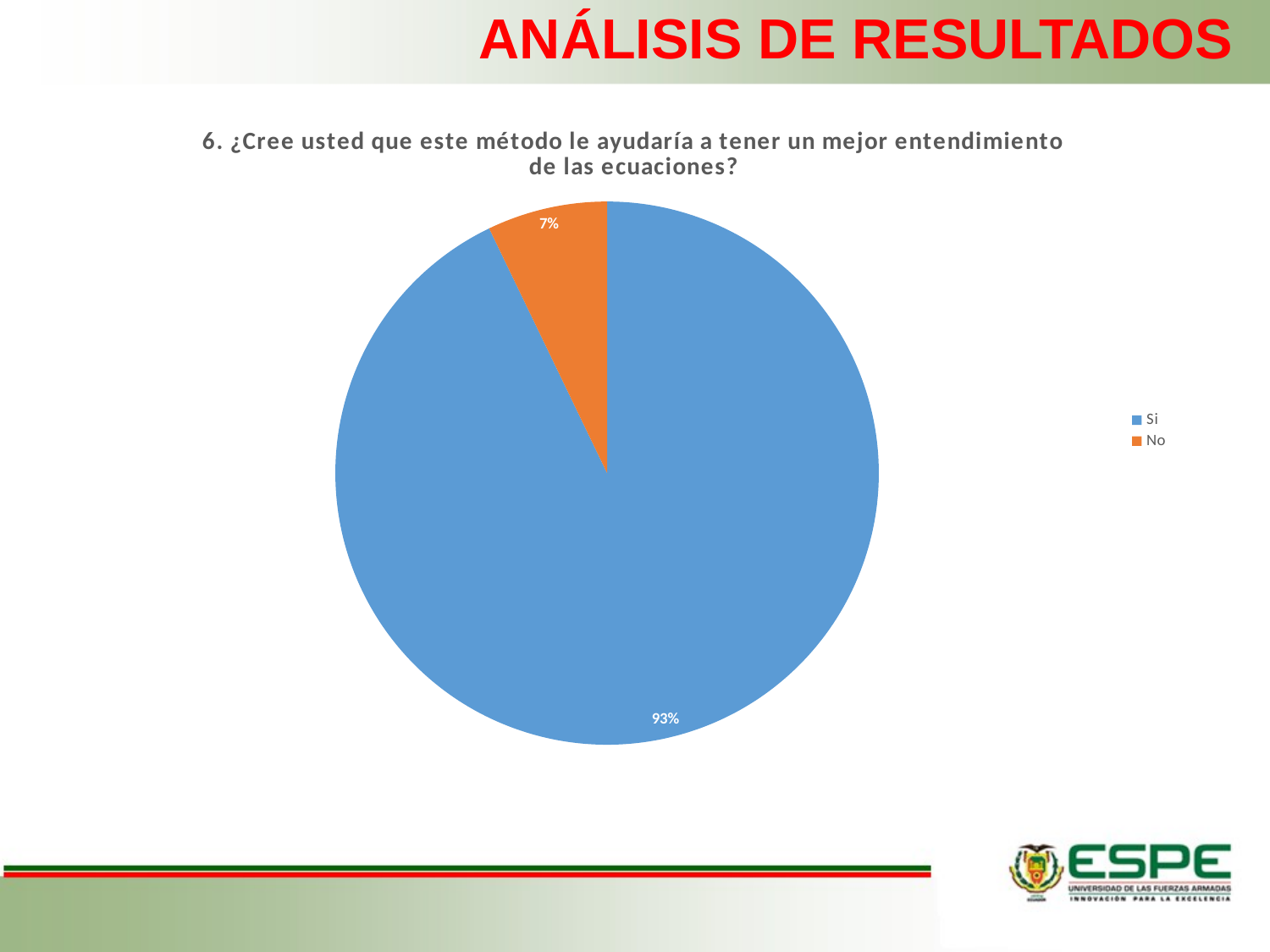
Which is larger, the share for "Si" or the share for "No"? Si Which category has the smallest share of the pie? No How many slices does the pie chart have? 2 What percentage of the pie corresponds to "Si"? 93% What percentage of the pie corresponds to "No"? 7% What kind of chart is shown on the slide? pie chart What colour is the "No" slice of the pie? orange Which category has the largest share of the pie? Si What is the title of the chart? 6. ¿Cree usted que este método le ayudaría a tener un mejor entendimiento de las ecuaciones? How many entries does the legend list? 2 What is the difference in percentage points between the "Si" and "No" slices? 86